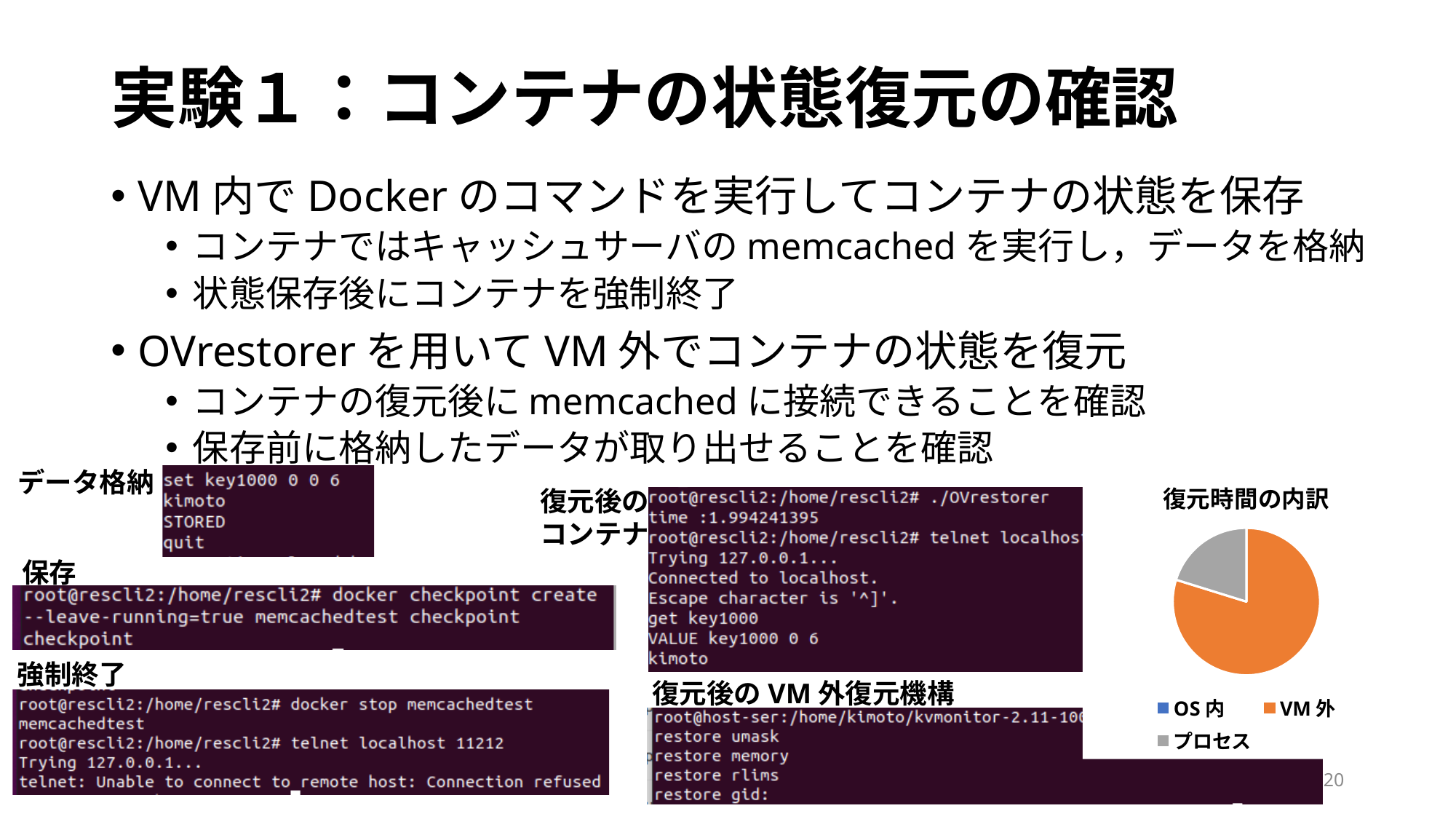
Which category takes up the largest share of the pie chart? VM 外 In the pie chart, which is larger: the slice for VM 外 or the slice for プロセス? VM 外 How many categories does the legend of the pie chart list? 3 What kind of chart is shown on the right side of the slide? pie chart Which colour represents VM 外 in the pie chart? orange What is the title of the pie chart on the slide? 復元時間の内訳 Which category in the pie chart legend has the smallest visible slice? プロセス